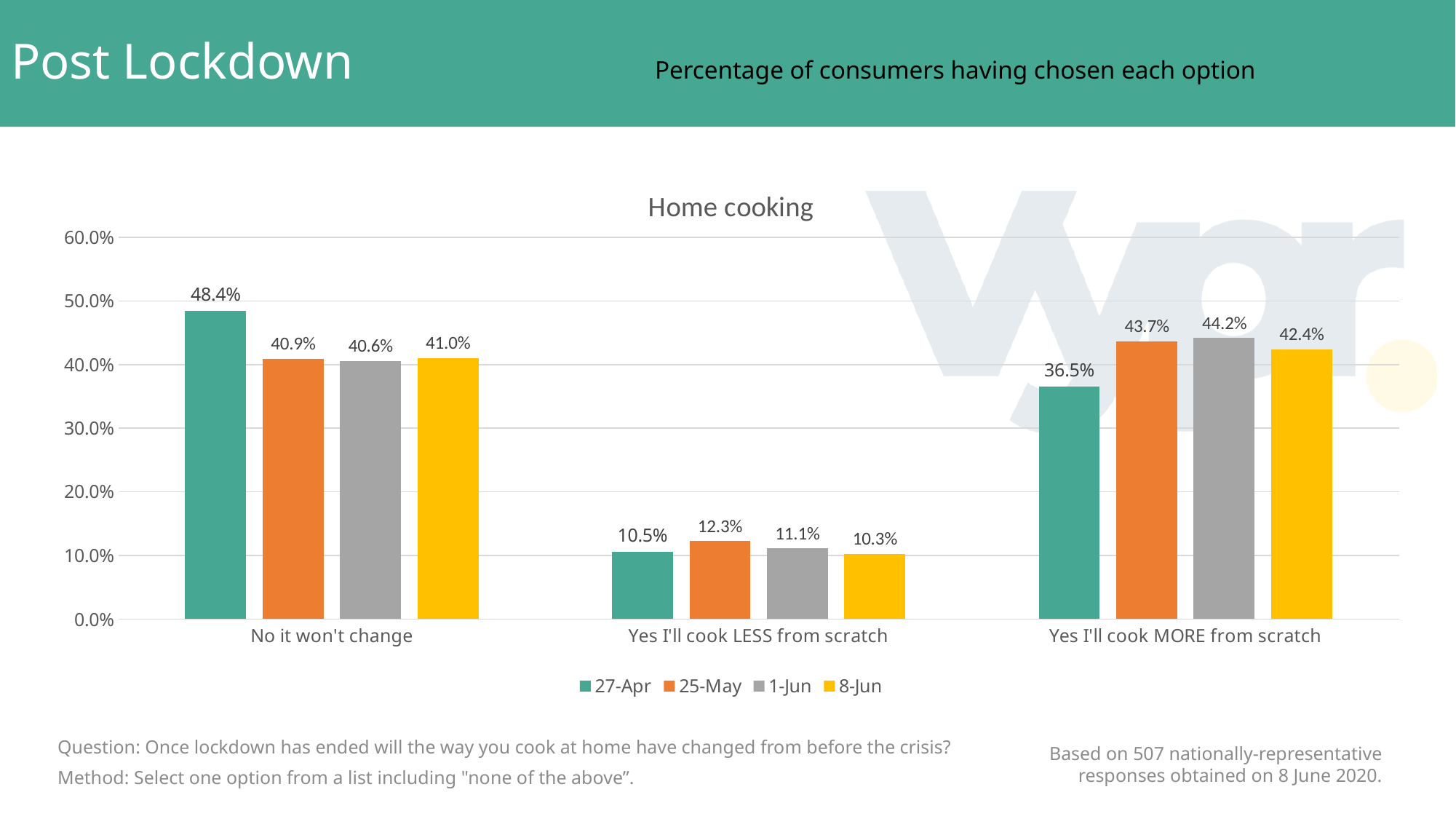
What is the value for 8-Jun in the 'Yes I'll cook MORE from scratch' category? 42.4% Which series has the highest value in the 'Yes I'll cook MORE from scratch' category? 1-Jun What is the difference between the 27-Apr and 8-Jun values in the 'No it won't change' category? 7.4% Which series has the lowest value in the 'Yes I'll cook LESS from scratch' category? 8-Jun What is the title of the chart? Home cooking What is the value for 27-Apr in the 'No it won't change' category? 48.4% How many categories are shown on the x axis? 3 Which is larger: the 27-Apr value for 'No it won't change' or the 27-Apr value for 'Yes I'll cook MORE from scratch'? No it won't change What is the value for 25-May in the 'Yes I'll cook LESS from scratch' category? 12.3% How many series does the legend list? 4 Is the 1-Jun value for 'Yes I'll cook MORE from scratch' greater or less than 40.0%? greater What kind of chart is shown on the slide? Bar chart